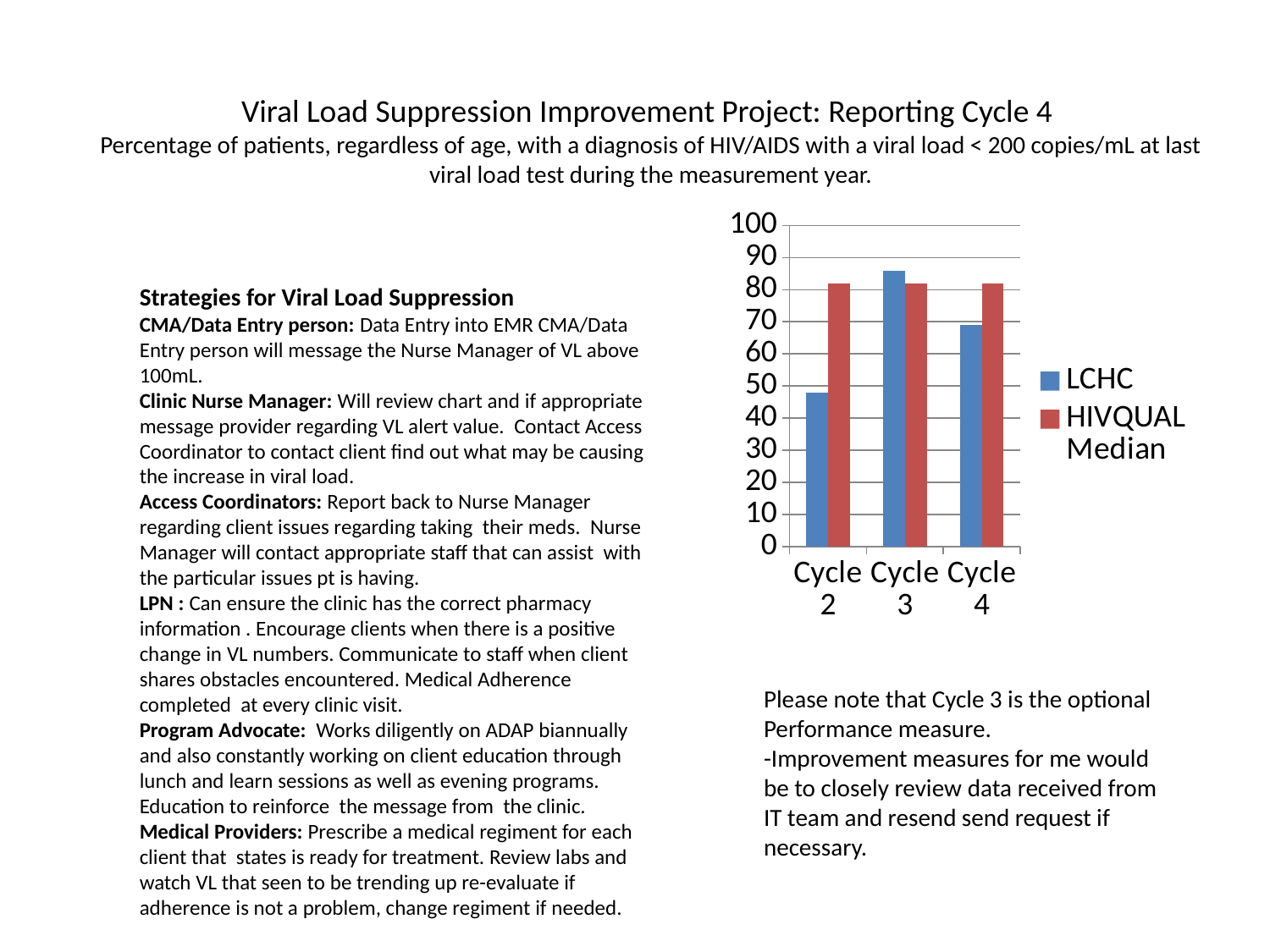
In Cycle 2, which is larger: LCHC or HIVQUAL Median? HIVQUAL Median What colour are the LCHC bars in the chart? blue How many series does the chart legend list? 2 Which cycle has the lowest LCHC value? Cycle 2 What kind of chart is shown on the slide? bar chart Which cycle has the highest LCHC value? Cycle 3 Is the LCHC value for Cycle 3 greater or less than 80? greater Is the LCHC value for Cycle 2 greater or less than 60? less How many cycles are shown on the x axis of the chart? 3 Does the LCHC value rise or fall from Cycle 3 to Cycle 4? fall Is the HIVQUAL Median value for Cycle 4 greater or less than 70? greater In Cycle 3, which is larger: LCHC or HIVQUAL Median? LCHC